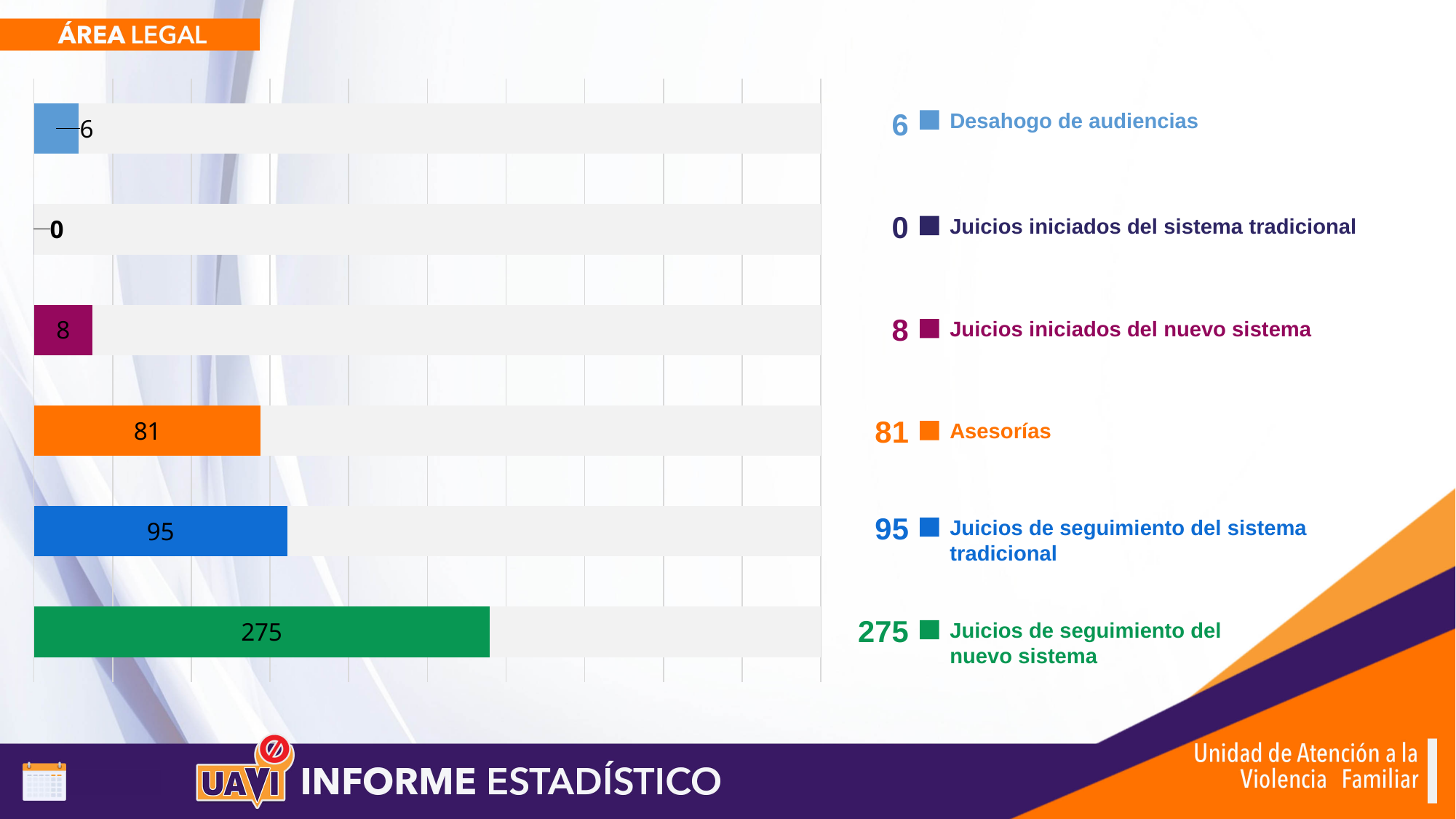
What colour is the bar for Asesorías? Orange What is the value for Asesorías? 81 Which is larger, Asesorías or Juicios de seguimiento del sistema tradicional? Juicios de seguimiento del sistema tradicional How many categories are shown in the chart? 6 What type of chart is shown on the slide? Bar chart What is the value for Desahogo de audiencias? 6 What is the difference between Juicios iniciados del nuevo sistema and Desahogo de audiencias? 2 What is the difference between Juicios de seguimiento del nuevo sistema and Juicios de seguimiento del sistema tradicional? 180 What is the value for Juicios de seguimiento del nuevo sistema? 275 What is the value for Juicios iniciados del sistema tradicional? 0 Which category has the highest value? Juicios de seguimiento del nuevo sistema Which category has the lowest value? Juicios iniciados del sistema tradicional